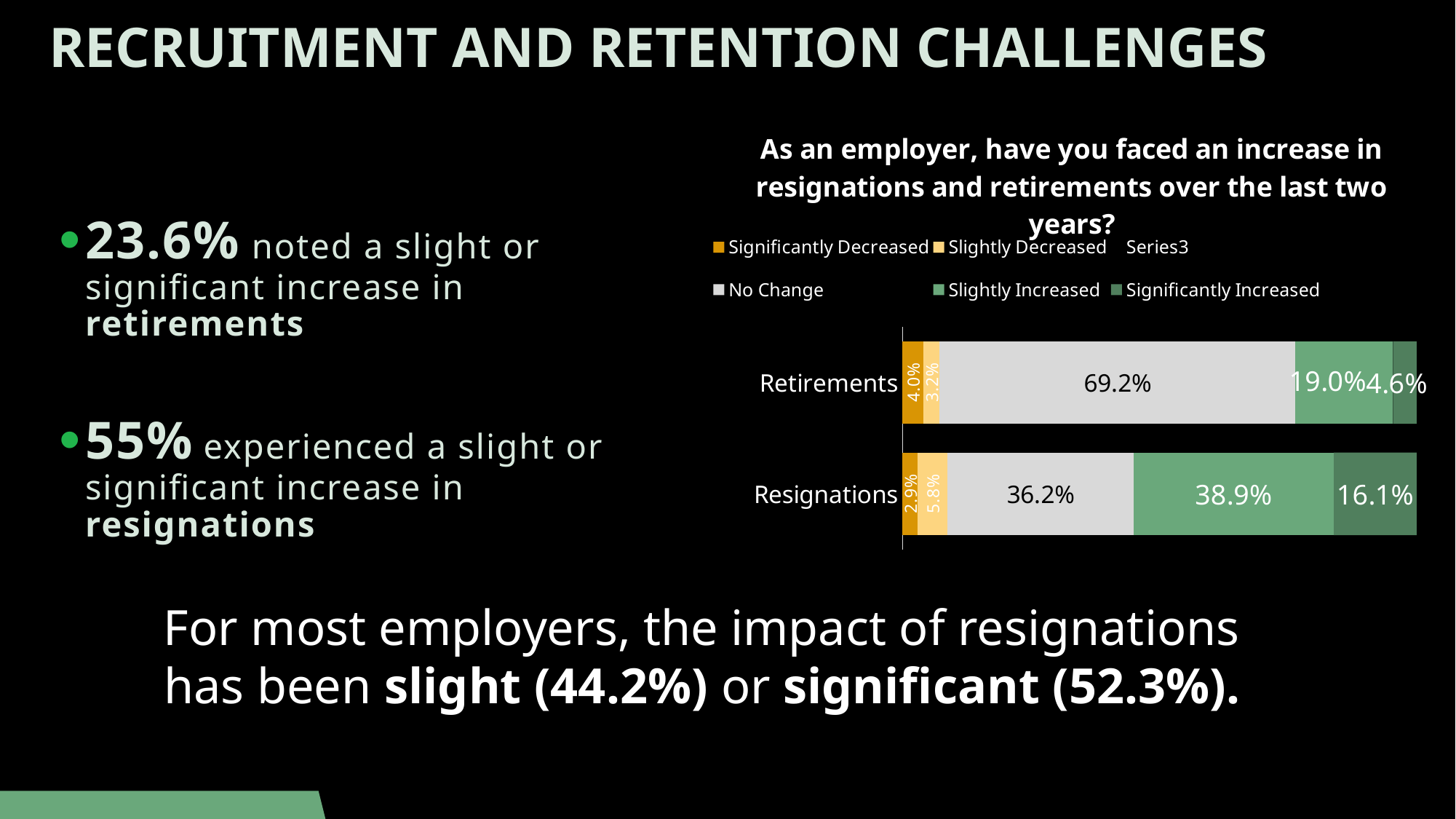
What is the Significantly Decreased value for Resignations? 2.9% What is the Slightly Decreased value for Retirements? 3.2% What is the No Change value for Retirements? 69.2% Which segment of the Resignations bar is the largest? Slightly Increased What is the Slightly Increased value for Resignations? 38.9% What is the Significantly Increased value for Retirements? 4.6% What kind of chart is shown on the slide? Stacked bar chart How many series does the legend list? 6 Which category has the larger No Change value, Retirements or Resignations? Retirements What is the difference between the Significantly Increased values for Resignations and Retirements? 11.5% What is the No Change value for Resignations? 36.2% How many categories are plotted on the chart? 2